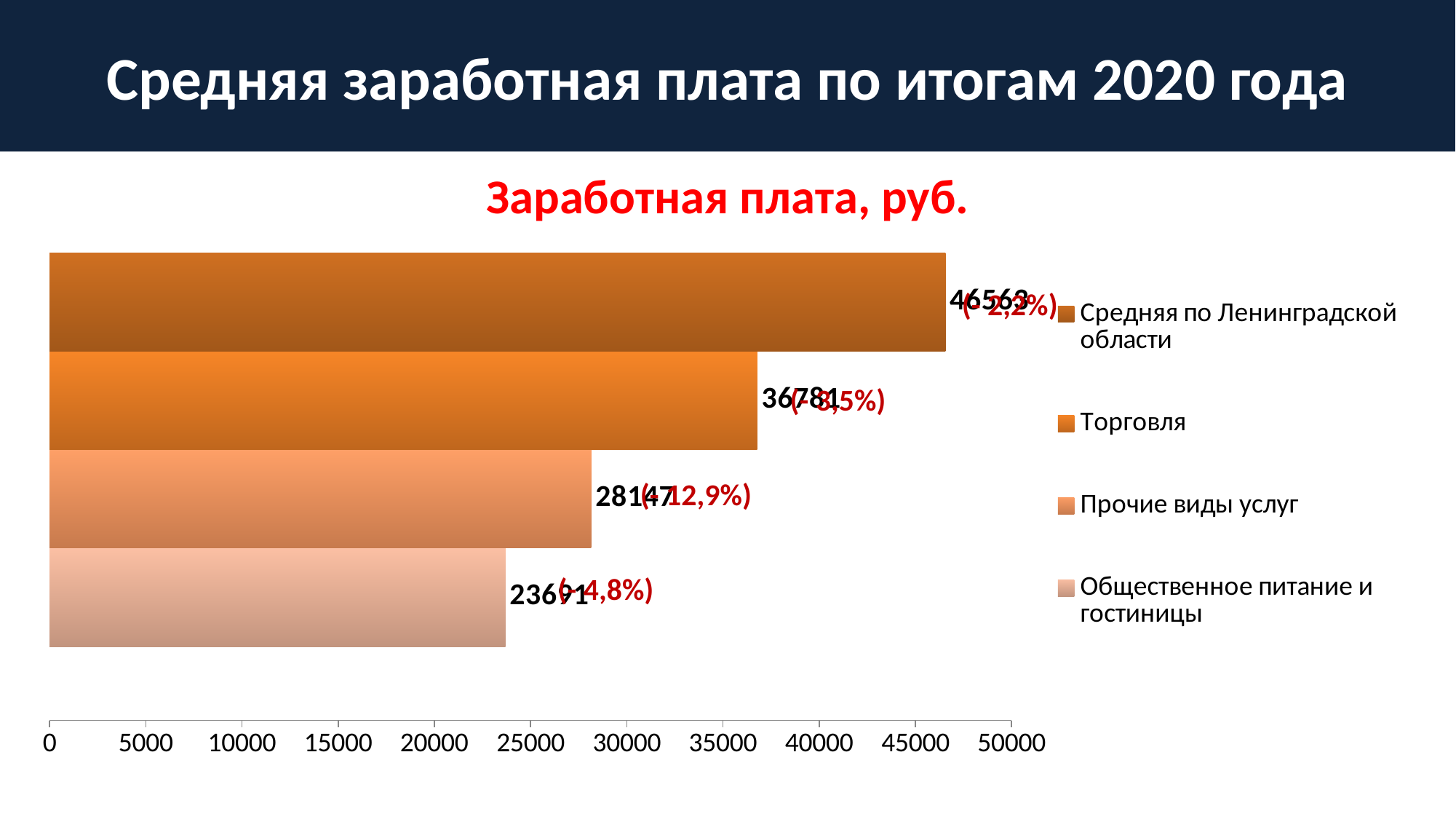
What is the value for Средняя по Ленинградской области? 46563 Which category has the lowest value in the chart? Общественное питание и гостиницы Is the value for Общественное питание и гостиницы greater or less than 25000? less What is the value for Торговля? 36781 How many entries does the chart legend list? 4 Which category has the highest value in the chart? Средняя по Ленинградской области Is the value for Прочие виды услуг greater or less than 25000? greater How many bars are plotted in the chart? 4 What is the title of the chart? Заработная плата, руб. What kind of chart is shown on the slide? bar chart What is the difference between the value for Средняя по Ленинградской области and the value for Торговля? 9782 Which is larger, the value for Торговля or the value for Прочие виды услуг? Торговля